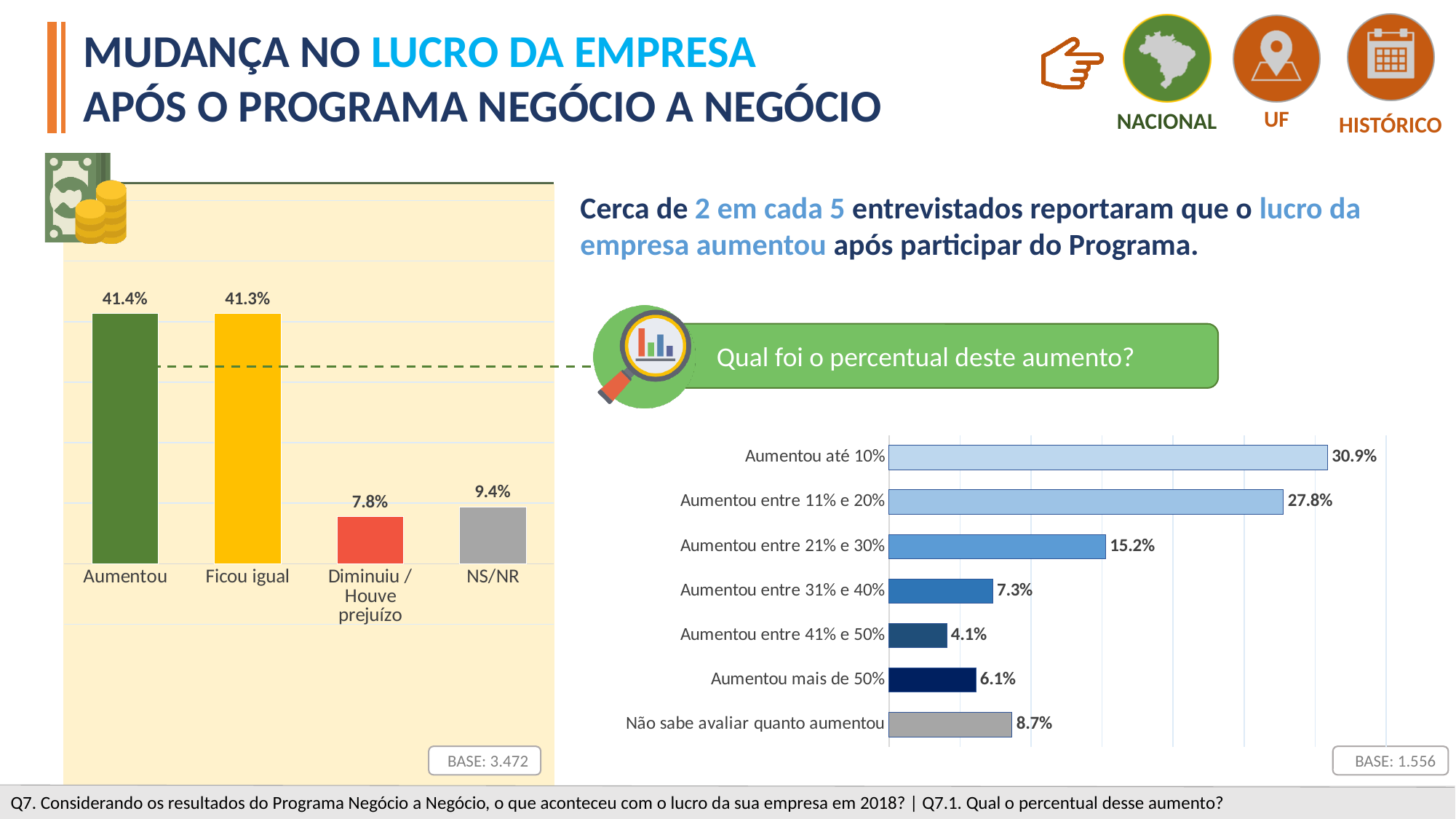
In the right chart, which category has the lowest value? Aumentou entre 41% e 50% In the left chart, what is the difference between 'NS/NR' and 'Diminuiu / Houve prejuízo'? 1.6% In the right chart, which is larger: 'Aumentou mais de 50%' or 'Aumentou entre 41% e 50%'? Aumentou mais de 50% In the left chart, what is the value for 'Diminuiu / Houve prejuízo'? 7.8% What type of chart is the left chart? Bar chart In the right chart, how many categories are shown? 7 In the left chart, what percentage of respondents said the company's profit 'Aumentou'? 41.4% In the left chart, which category has the lowest value? Diminuiu / Houve prejuízo In the right chart, what is the value for 'Aumentou entre 21% e 30%'? 15.2% In the left chart, how many categories are shown? 4 In the right chart, which category has the highest value? Aumentou até 10% In the right chart, what is the value for 'Não sabe avaliar quanto aumentou'? 8.7%